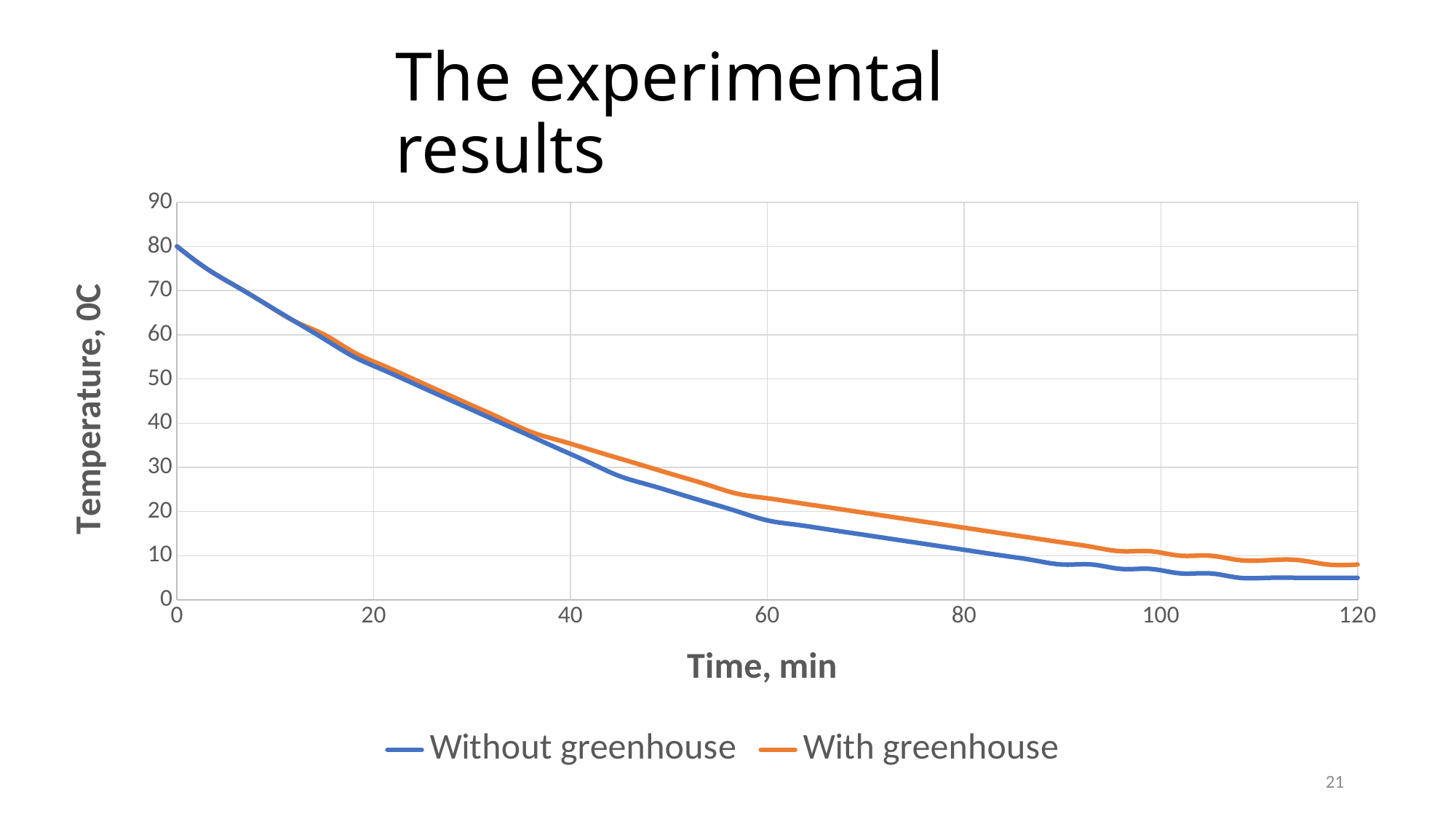
Is the value for Without greenhouse at 60 min greater or less than 20? less How many series does the legend list? 2 Is the value for With greenhouse at 80 min greater or less than 10? greater Is the value for Without greenhouse at 120 min greater or less than 10? less What kind of chart is shown on the slide? line chart Do the temperature values rise or fall as time increases along the x axis? fall What is the title of the x axis? Time, min What is the temperature for Without greenhouse at time 0 min? 80 Which colour is used for the With greenhouse series? orange At 100 min, which series has the higher temperature, Without greenhouse or With greenhouse? With greenhouse